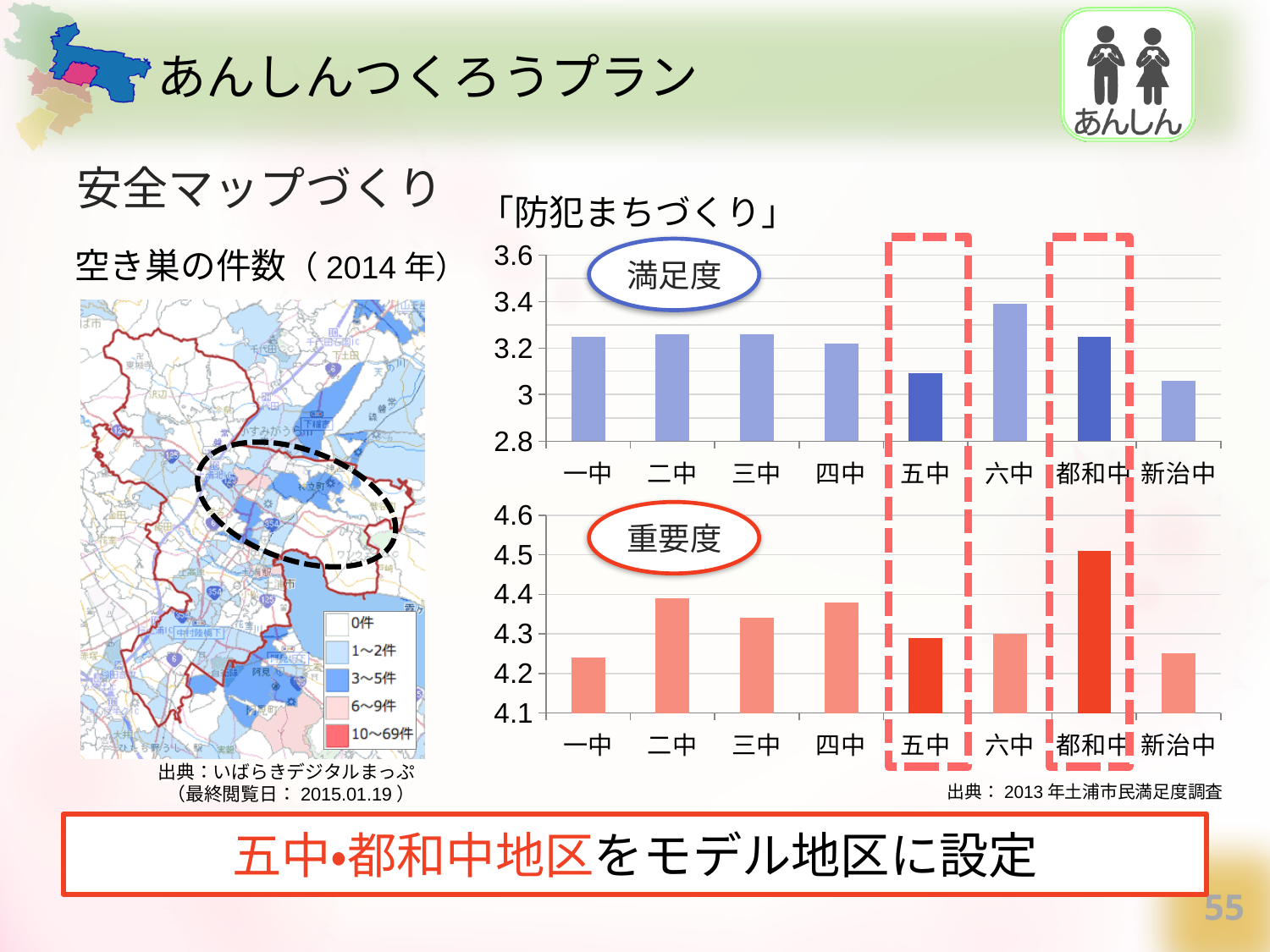
In the 重要度 chart, which is larger, the value for 都和中 or the value for 一中? 都和中 In the 重要度 chart, is the value for 都和中 greater or less than 4.4? greater In the 重要度 chart, which category has the highest value? 都和中 In the 満足度 chart, which is larger, the value for 四中 or the value for 五中? 四中 In the 重要度 chart, is the value for 一中 greater or less than 4.3? less How many categories are shown on the x axis of the 満足度 chart? 8 In the 重要度 chart, is the value for 二中 greater or less than 4.3? greater What kind of chart is the 重要度 chart? bar chart Which two categories are highlighted with red dashed boxes across both charts? 五中 and 都和中 In the 満足度 chart, which category has the highest value? 六中